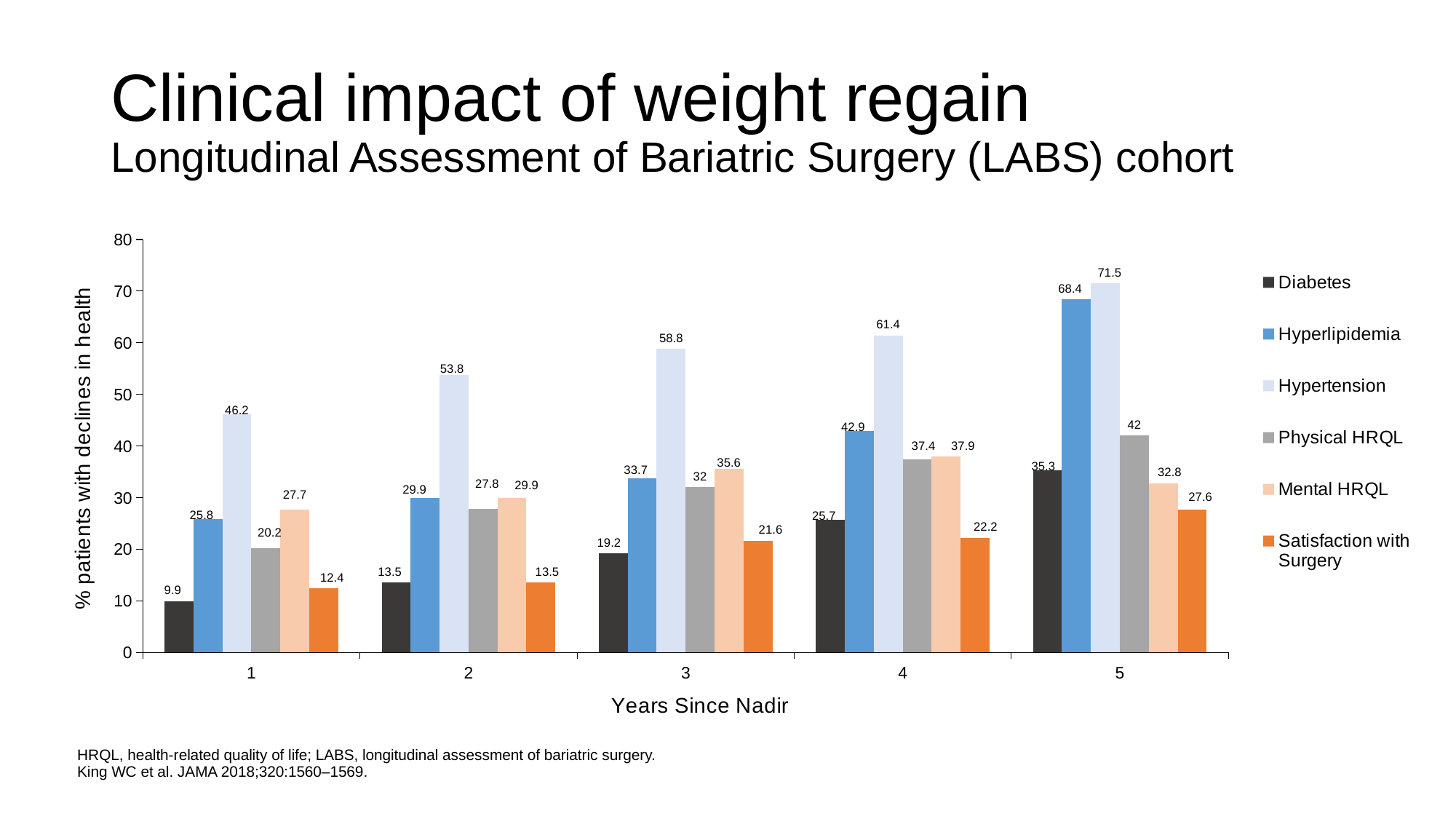
How many series does the legend list? 6 What is the value for Diabetes at 1 year since nadir? 9.9 Is the value for Hyperlipidemia at 5 years since nadir greater or less than 60? greater What is the difference between the Hypertension values at 5 years and 1 year since nadir? 25.3 Which series has the highest value at 5 years since nadir? Hypertension What is the value for Satisfaction with Surgery at 5 years since nadir? 27.6 Do the Hypertension values rise or fall as years since nadir increase? Rise Which is larger at 4 years since nadir: Physical HRQL or Mental HRQL? Mental HRQL What is the value for Hypertension at 3 years since nadir? 58.8 What kind of chart is shown on the slide? Bar chart Which series has the lowest value at 2 years since nadir? Diabetes and Satisfaction with Surgery (tied at 13.5) How many year categories are shown on the x axis? 5